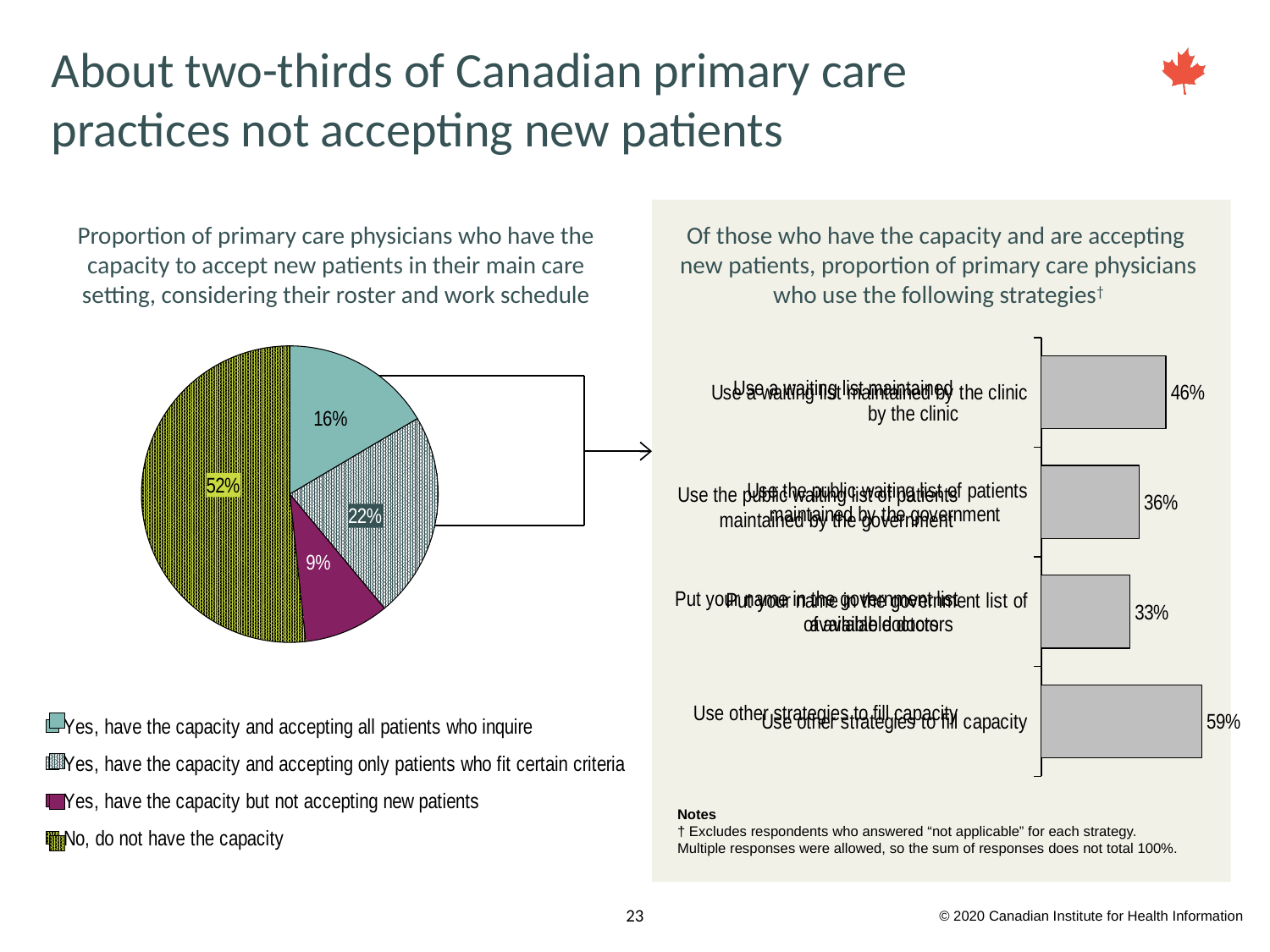
In the bar chart on the right, what is the difference between the proportion using other strategies to fill capacity and the proportion using the public waiting list maintained by the government? 23% In the bar chart on the right, what proportion put their name in the government list of available doctors? 33% In the bar chart on the right, which is larger: the proportion using the public waiting list maintained by the government or the proportion using a waiting list maintained by the clinic? Use a waiting list maintained by the clinic In the pie chart on the left, which response category has the smallest share? Yes, have the capacity but not accepting new patients What type of chart is shown on the right side of the slide? Bar chart In the pie chart on the left, how many response categories does the legend list? 4 In the bar chart on the right, what proportion of physicians use a waiting list maintained by the clinic? 46% In the pie chart on the left, what percentage of primary care physicians answered "No, do not have the capacity"? 52% In the bar chart on the right, which strategy has the highest proportion? Use other strategies to fill capacity In the pie chart on the left, what is the difference between the share accepting only patients who fit certain criteria and the share accepting all patients who inquire? 6% In the pie chart on the left, what percentage answered "Yes, have the capacity and accepting all patients who inquire"? 16% In the pie chart on the left, which response category has the largest share? No, do not have the capacity